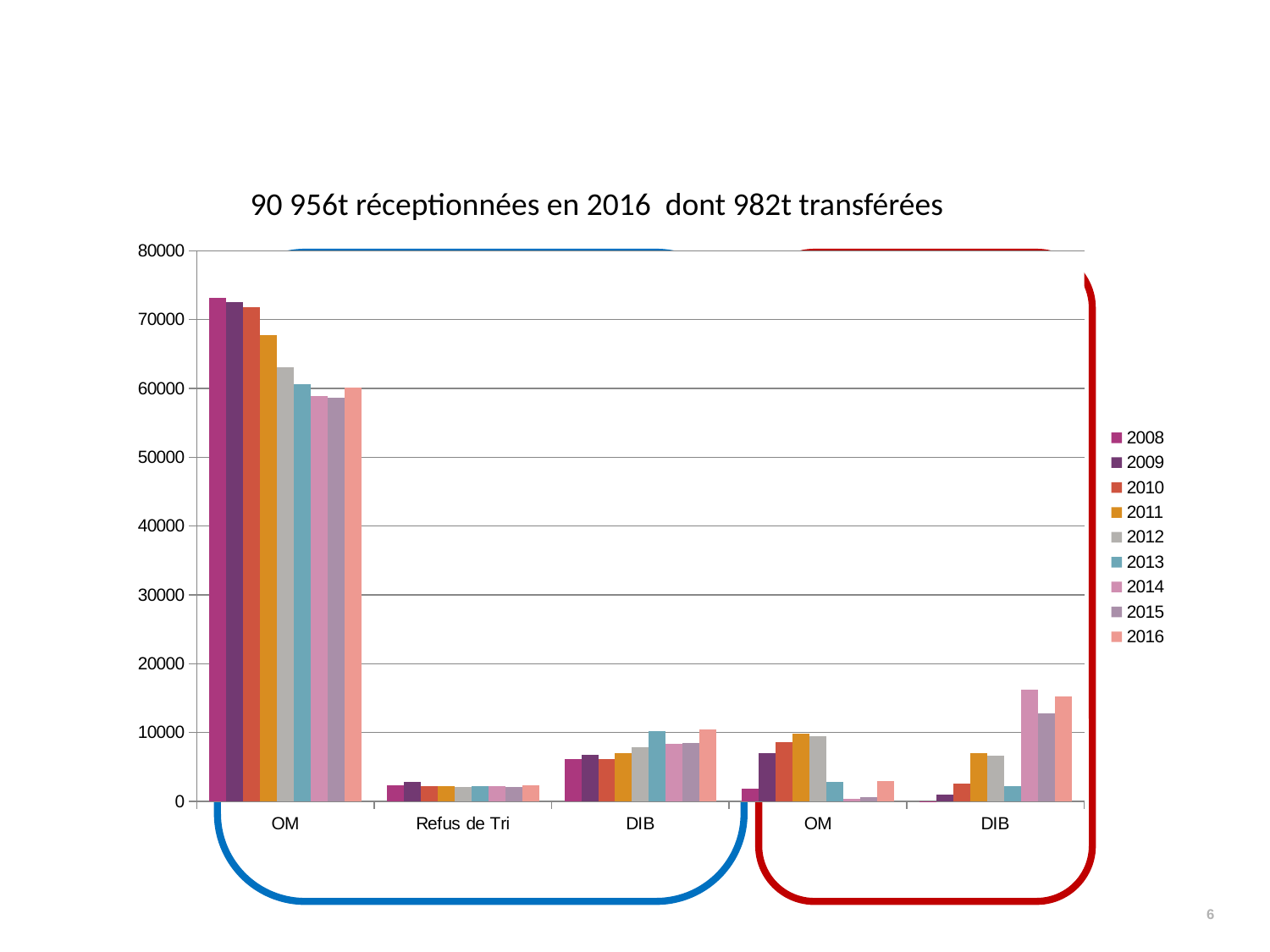
What kind of chart is shown on the slide? bar chart What is the title of the chart? 90 956t réceptionnées en 2016 dont 982t transférées Is the 2008 value for the leftmost OM category greater or less than 70000? greater For the leftmost OM category, do the values generally rise or fall from 2008 to 2016? fall Is the 2012 value for the leftmost OM category greater or less than 60000? greater Which category group has the tallest bars overall? OM (leftmost) Is the 2014 value for the rightmost DIB category greater or less than 10000? greater How many category groups are shown along the x axis? 5 Which years does the legend cover, from first to last entry? 2008 to 2016 How many series does the legend list? 9